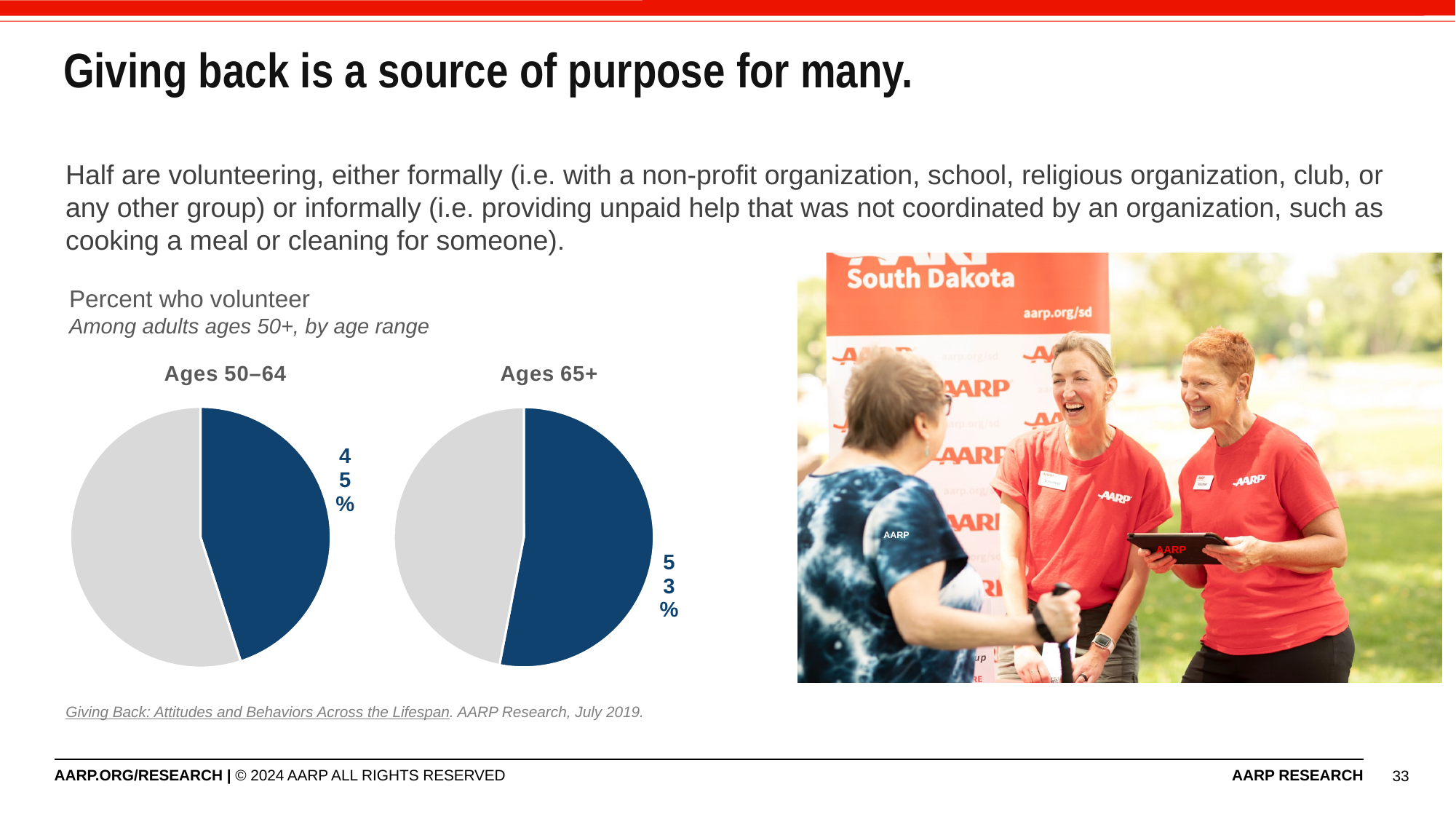
In the 'Ages 65+' pie chart, what percent volunteer? 53% How many pie charts are shown on the slide? 2 In the 'Ages 50–64' pie chart, what percent volunteer? 45% In the 'Ages 65+' pie chart, is the blue slice more than half of the pie? Yes Which age group's pie chart is on the left? Ages 50–64 What kind of charts are used to show the percent who volunteer? Pie charts What colour is the slice representing those who volunteer in the pie charts? Dark blue What is the title of the chart section showing the two pie charts? Percent who volunteer What is the difference in percentage points between the percent who volunteer among Ages 65+ and Ages 50–64? 8 In the 'Ages 50–64' pie chart, is the blue slice less than half of the pie? Yes Which age group has the higher percent who volunteer, Ages 50–64 or Ages 65+? Ages 65+